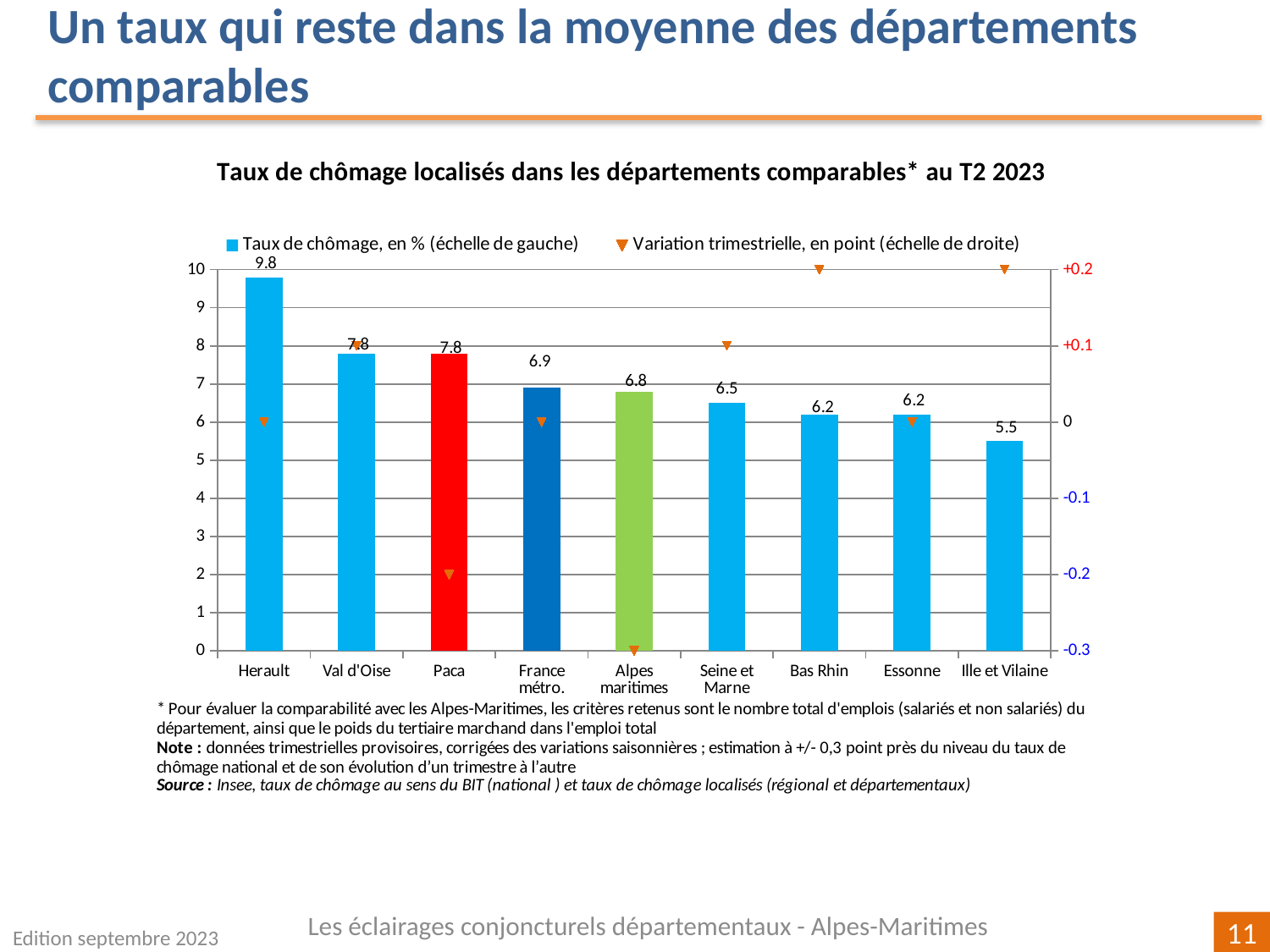
Which department has the lowest unemployment rate on the chart? Ille et Vilaine What is the quarterly variation (Variation trimestrielle, right-hand scale) for Alpes maritimes? -0.3 How many departments or areas are shown on the x axis of the chart? 9 What is the difference between the unemployment rate of Herault and that of Ille et Vilaine? 4.3 How many series does the legend of the chart list? 2 What is the unemployment rate (Taux de chômage) for France métro.? 6.9 Which has a higher unemployment rate, Seine et Marne or Alpes maritimes? Alpes maritimes What is the unemployment rate (Taux de chômage) for Alpes maritimes? 6.8 What kind of chart is used to show the unemployment rates? Bar chart Which department has the highest unemployment rate on the chart? Herault What is the title of the chart? Taux de chômage localisés dans les départements comparables* au T2 2023 What is the unemployment rate (Taux de chômage) for Herault? 9.8